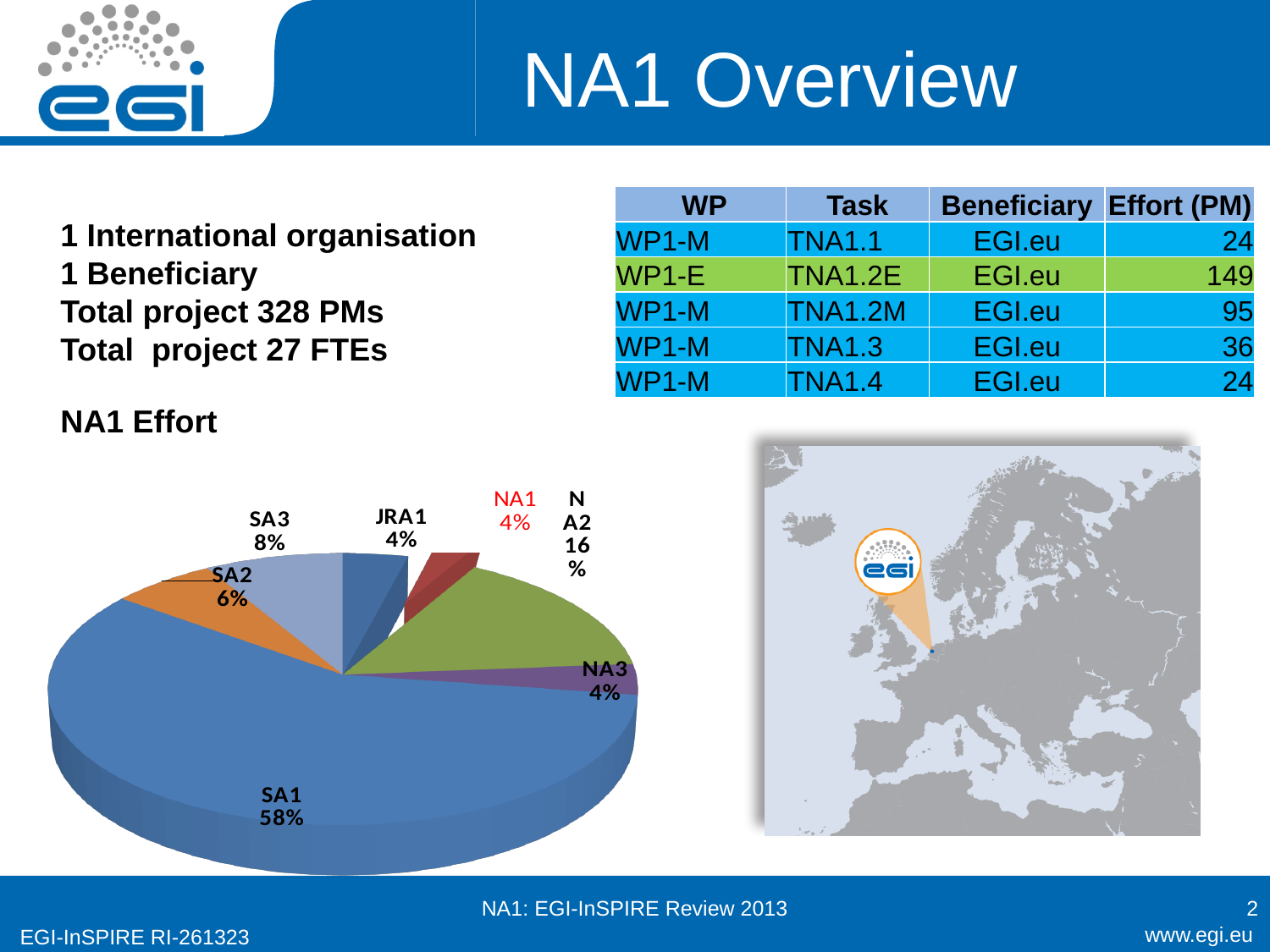
In the pie chart, which is larger, SA3 or SA2? SA3 What is the difference in percentage points between SA1 and NA2 in the pie chart? 42 What kind of chart is shown on the slide? Pie chart What percentage is shown for NA1 in the pie chart? 4% Which slice of the pie chart is the largest? SA1 In the pie chart, which is larger, NA2 or SA3? NA2 Which slice label in the pie chart is written in red? NA1 What share of the pie chart does SA1 account for? 58% What percentage is shown for SA2 in the pie chart? 6% What percentage is shown for NA2 in the pie chart? 16% What percentage is shown for SA3 in the pie chart? 8% How many slices does the pie chart have? 7